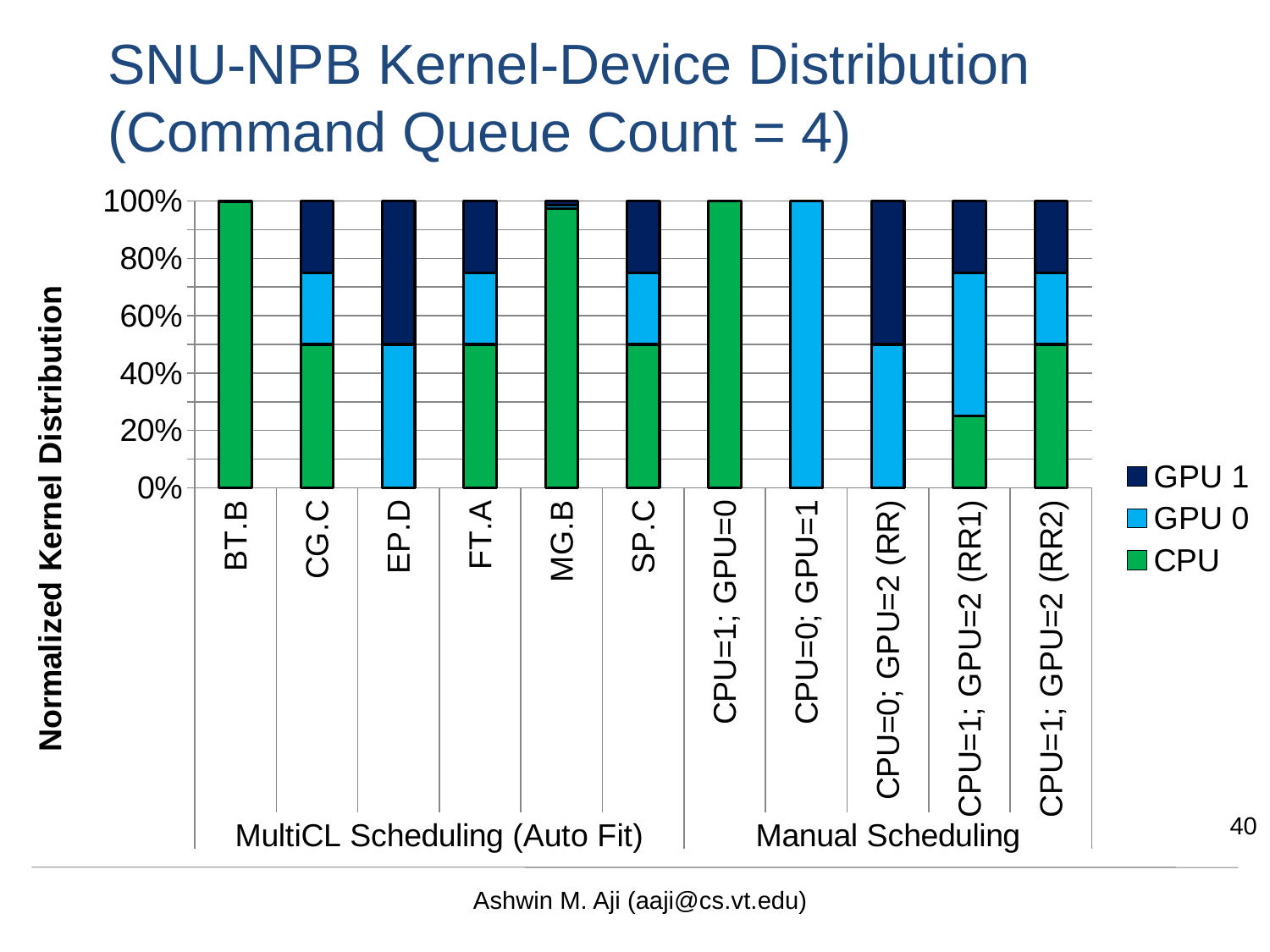
What is the CPU value for CPU=1; GPU=0? 100% How many categories are in the MultiCL Scheduling (Auto Fit) group? 6 How many bars (categories) are plotted in the chart? 11 Is the CPU value for CG.C greater or less than 40%? greater Is the GPU 1 value for EP.D greater or less than 40%? greater How many series does the legend list? 3 Is the CPU value for CPU=1; GPU=2 (RR1) greater or less than 40%? less What kind of chart is shown on the slide? stacked bar chart What is the label of the vertical axis? Normalized Kernel Distribution Which is larger for MG.B, the CPU value or the GPU 1 value? CPU What is the GPU 0 value for CPU=0; GPU=1? 100%